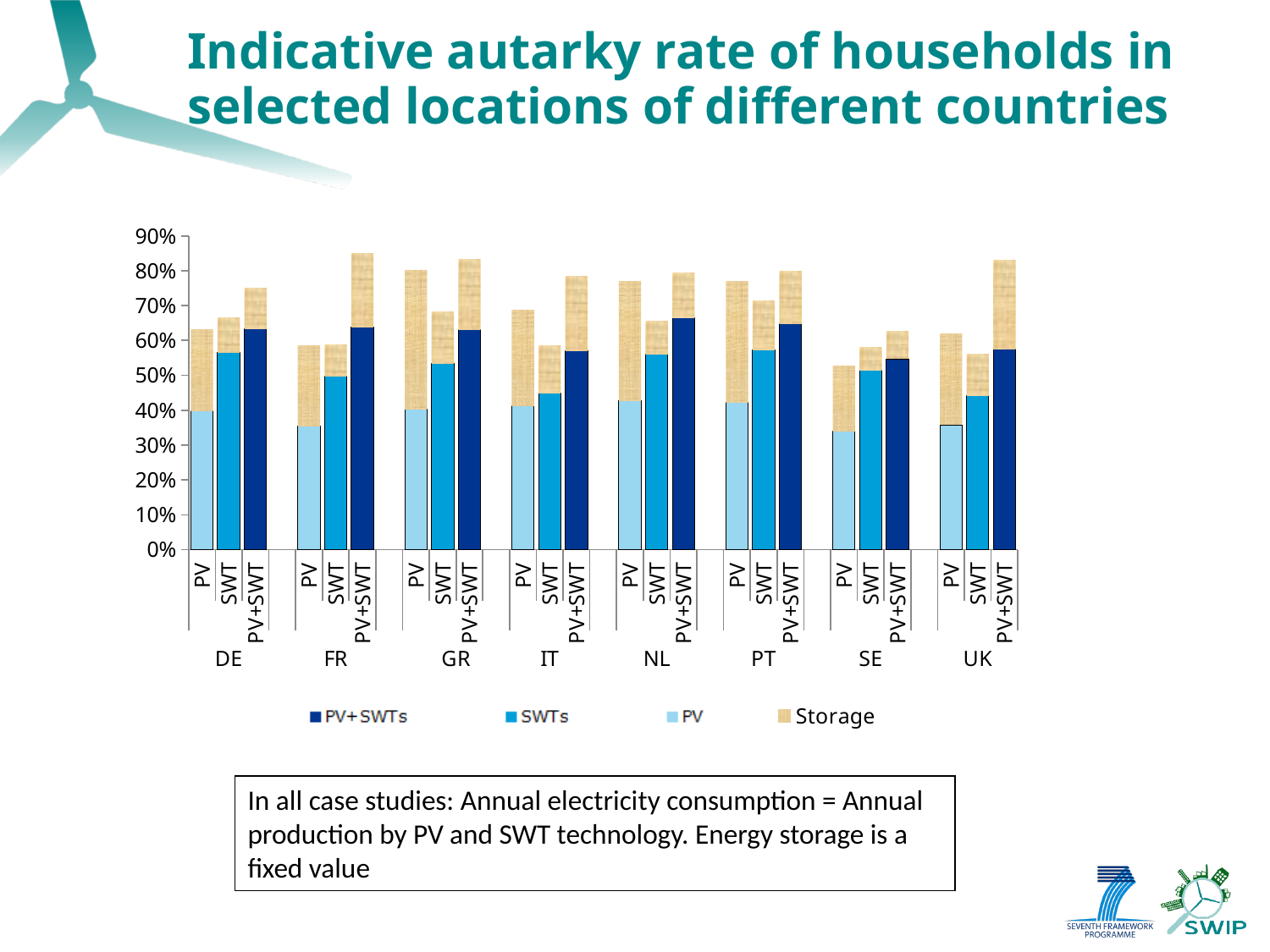
Is the total height of the PV+SWT bar for SE greater or less than 70%? less How many series does the chart legend list? 4 Which series is shown in the beige colour at the top of each stacked bar? Storage Which is taller in total: the PV bar for GR or the PV bar for IT? GR Which is taller in total: the PV+SWT bar for DE or the PV+SWT bar for FR? FR Is the total height of the PV+SWT bar for FR greater or less than 80%? greater How many countries are shown along the x axis of the chart? 8 Is the total height of the PV bar for SE greater or less than 60%? less What kind of chart is shown on the slide? Stacked bar chart What is the title of the chart on the slide? Indicative autarky rate of households in selected locations of different countries